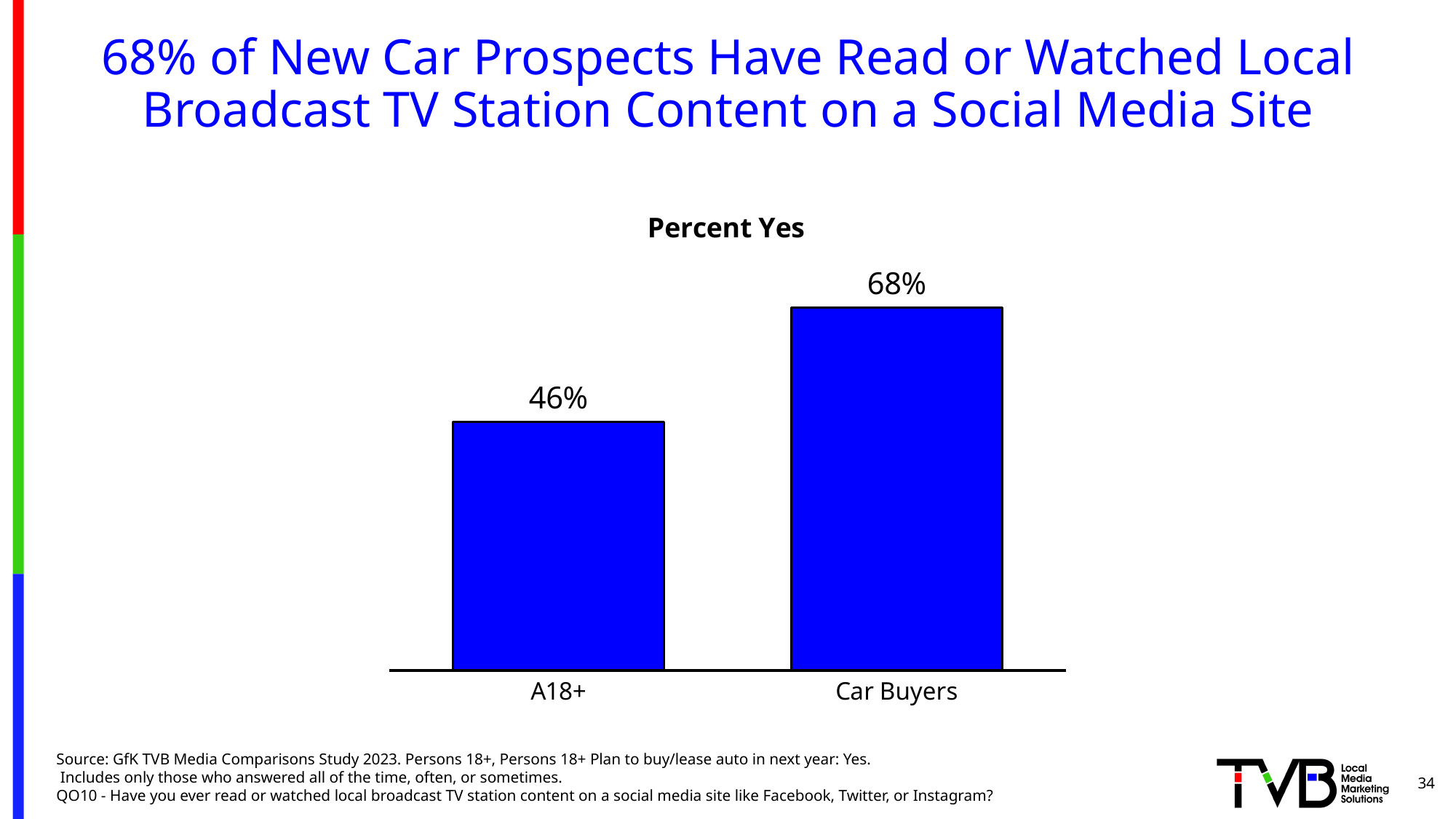
What is the difference in Percent Yes between Car Buyers and A18+? 22% What is the title of the chart? Percent Yes Which is larger, the Percent Yes value for A18+ or for Car Buyers? Car Buyers Which category has the highest Percent Yes value? Car Buyers What is the Percent Yes value for A18+? 46% How many categories are shown in the chart? 2 Which category has the lowest Percent Yes value? A18+ What colour are the bars in the chart? Blue What is the Percent Yes value for Car Buyers? 68% What kind of chart is shown on the slide? Bar chart